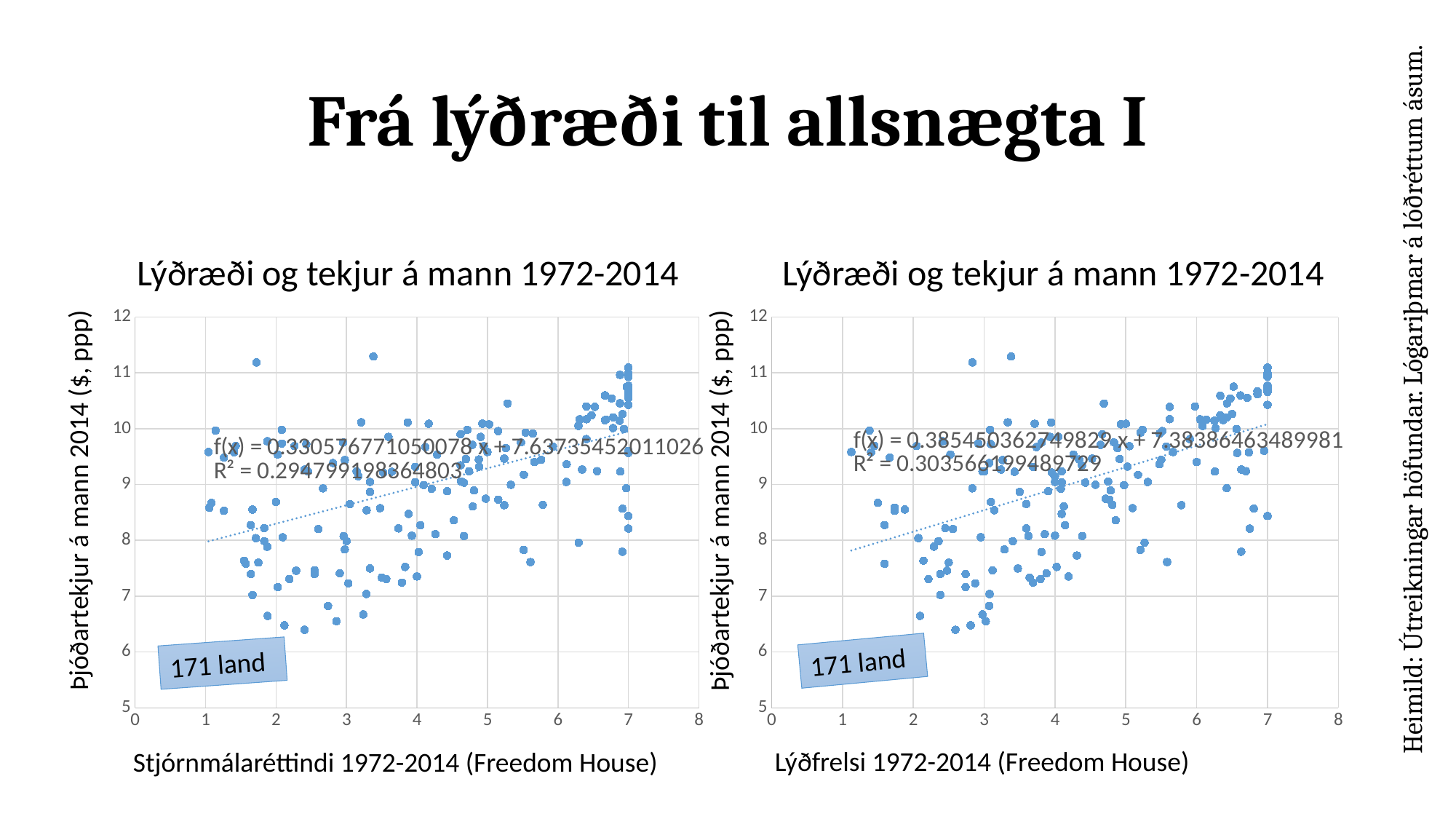
What is the R² value shown on the right chart? 0.303566199489729 What is the R² value shown on the left chart? 0.294799198364803 What kind of chart is the left chart on the slide? Scatter chart According to the label on the left chart, how many countries are plotted? 171 According to the label on the right chart, how many countries are plotted? 171 What is the x-axis label of the left chart? Stjórnmálaréttindi 1972-2014 (Freedom House) Which chart has the higher R² value, the left chart or the right chart? The right chart In the right chart, do the values generally rise or fall as the x-axis value increases? Rise What kind of chart is the right chart on the slide? Scatter chart What is the x-axis label of the right chart? Lýðfrelsi 1972-2014 (Freedom House) What is the highest value shown on the y-axis of the left chart? 12 In the left chart, do the values generally rise or fall as the x-axis value increases? Rise